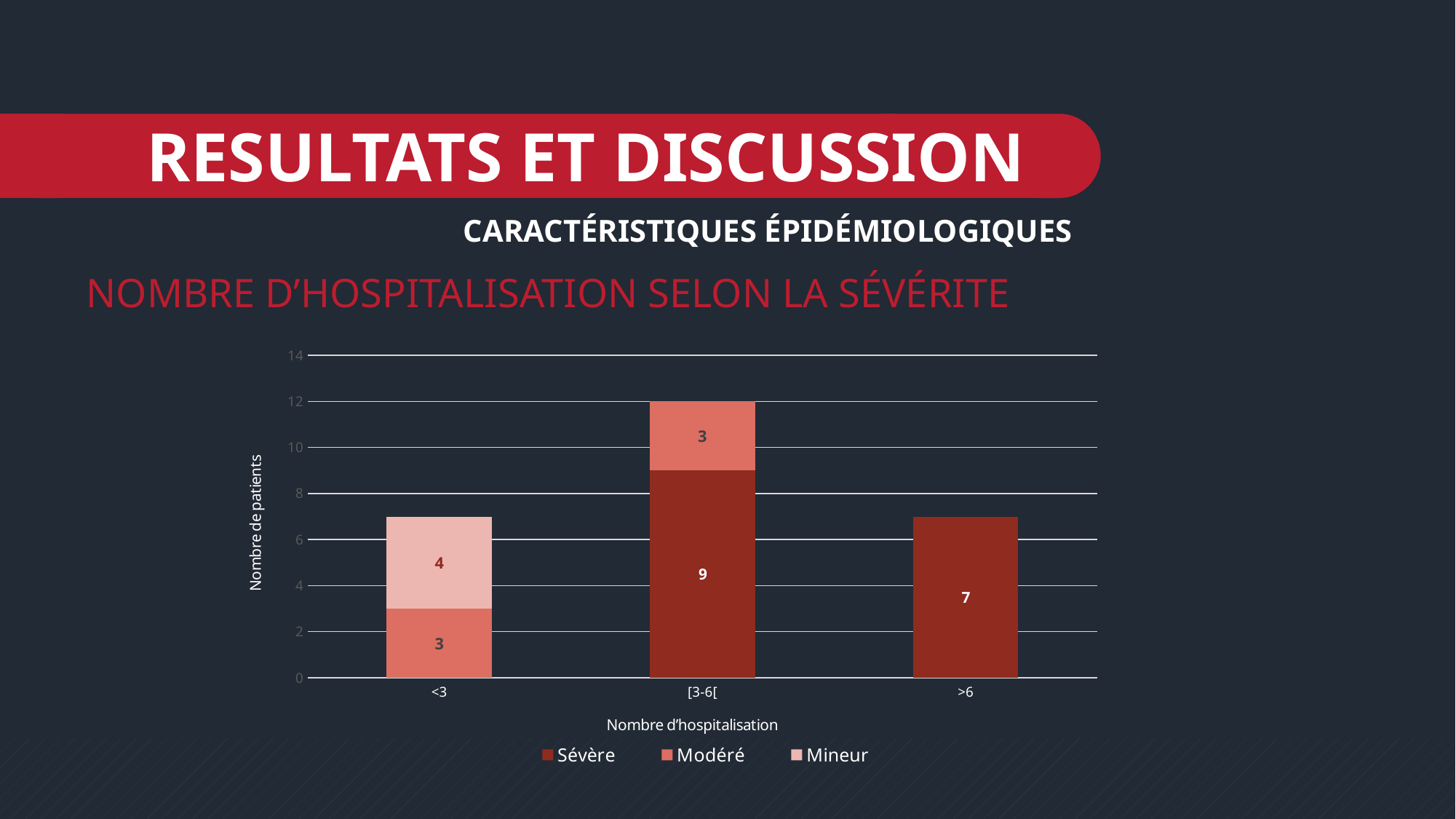
What is the value for Mineur in the <3 category? 4 How many categories are shown on the x axis? 3 What is the value for Sévère in the >6 category? 7 What is the label of the y axis? Nombre de patients Which category has the highest total number of patients? [3-6[ What is the value for Sévère in the [3-6[ category? 9 How many series does the legend list? 3 What is the value for Modéré in the <3 category? 3 What is the difference between the Sévère value in [3-6[ and the Sévère value in >6? 2 What type of chart is shown on the slide? stacked bar chart What is the total of the stacked bar for the [3-6[ category? 12 What is the total of the stacked bar for the <3 category? 7